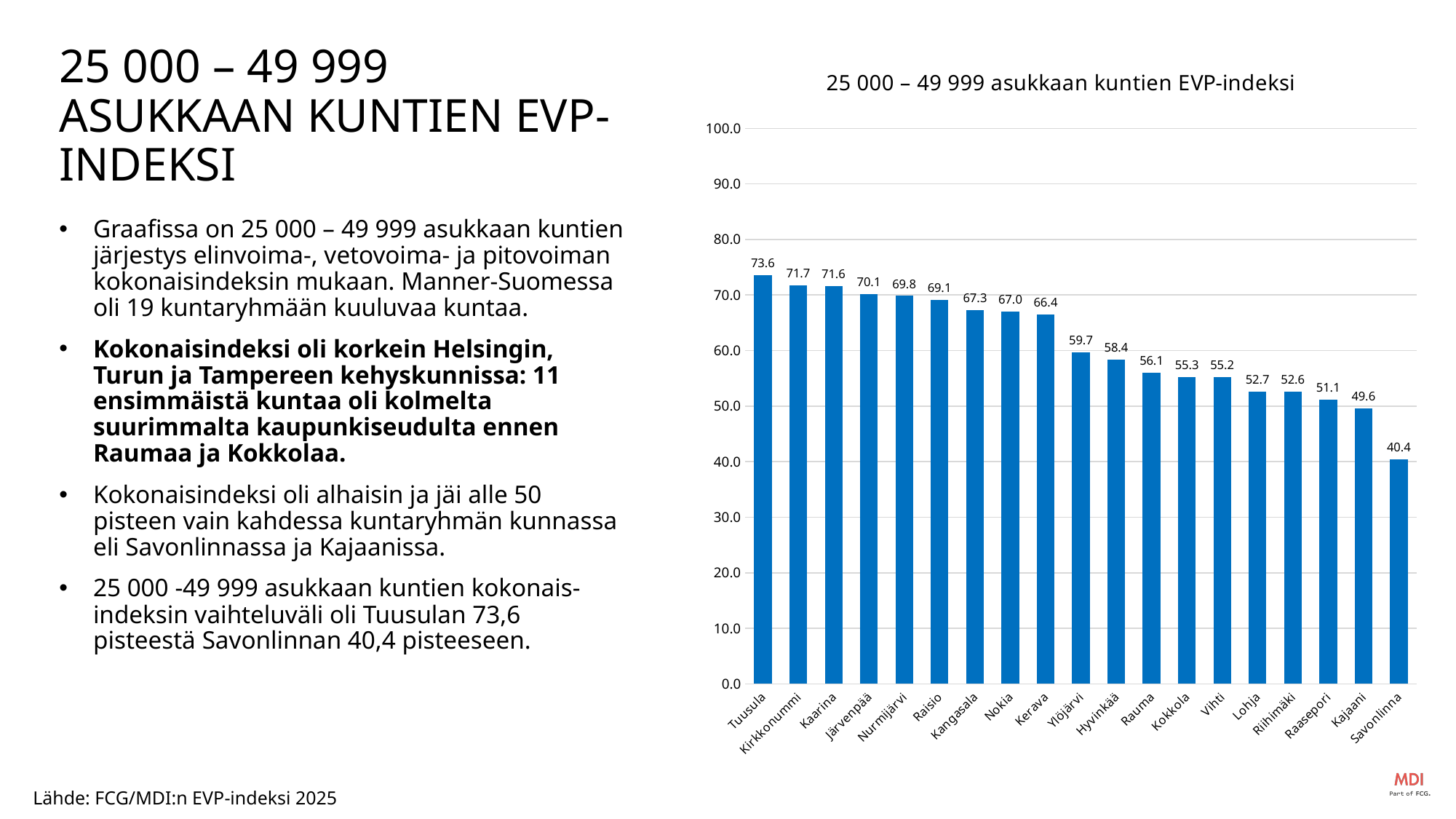
Which municipality has the lowest EVP index in the chart? Savonlinna How many municipalities are shown in the chart? 19 Do the values rise or fall from left to right along the x axis? Fall Is the value for Raasepori greater or less than 50.0? greater Which has a higher EVP index, Kerava or Rauma? Kerava What is the EVP index value for Tuusula? 73.6 What is the EVP index value for Kajaani? 49.6 What is the difference between the EVP index values of Tuusula and Savonlinna? 33.2 What is the EVP index value for Kokkola? 55.3 What is the difference between the EVP index values of Ylöjärvi and Hyvinkää? 1.3 Which municipality has the highest EVP index in the chart? Tuusula What type of chart is shown on the slide? Bar chart